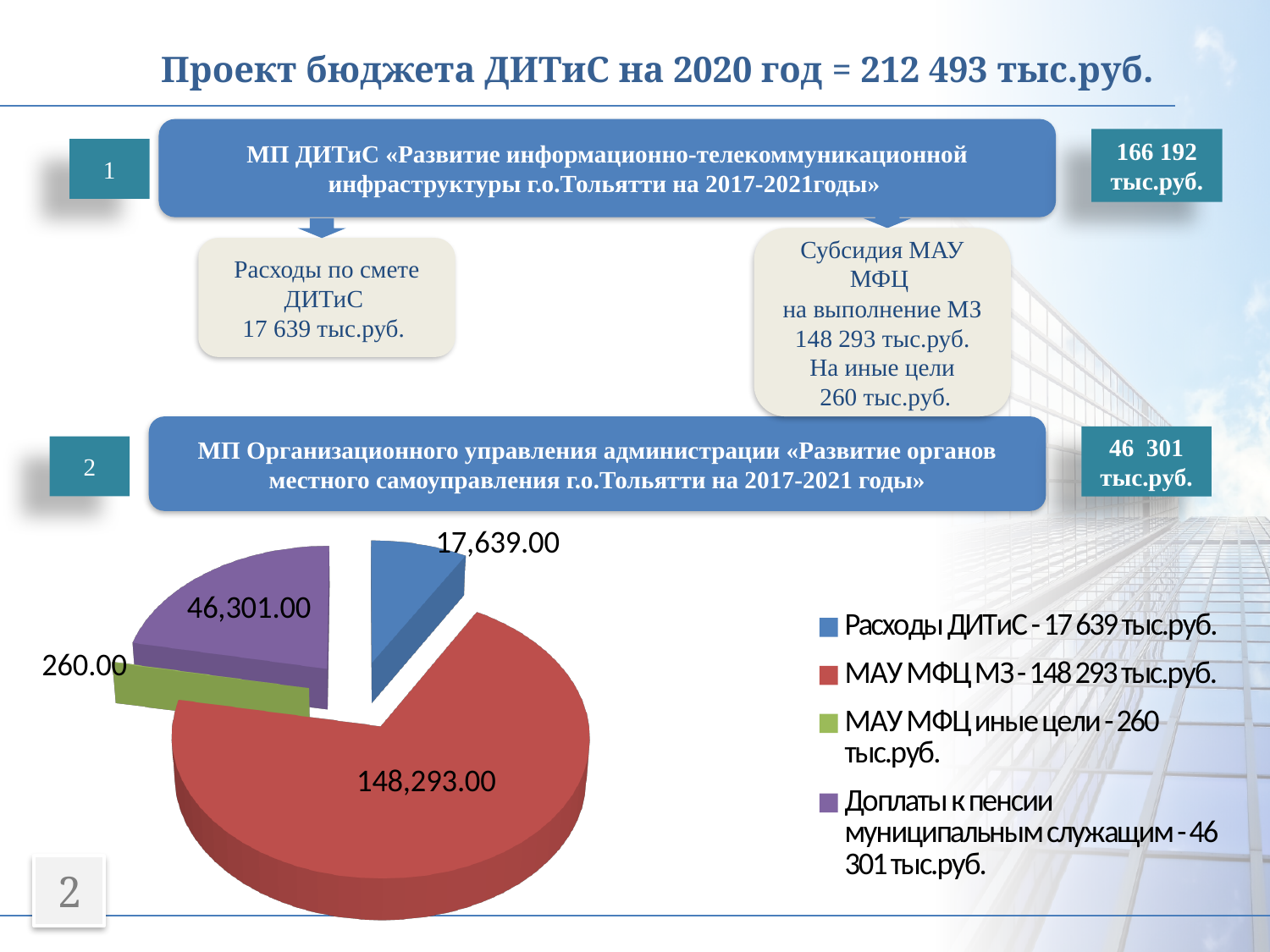
What is the value of the slice for МАУ МФЦ МЗ in the pie chart? 148,293.00 What is the value of the slice for Расходы ДИТиС in the pie chart? 17,639.00 Which is larger in the pie chart: Расходы ДИТиС or Доплаты к пенсии муниципальным служащим? Доплаты к пенсии муниципальным служащим Which category has the smallest slice in the pie chart? МАУ МФЦ иные цели What is the difference between the МАУ МФЦ МЗ slice and the Доплаты к пенсии муниципальным служащим slice? 101,992.00 What is the value of the slice for МАУ МФЦ иные цели in the pie chart? 260.00 What is the value of the slice for Доплаты к пенсии муниципальным служащим in the pie chart? 46,301.00 How many slices does the pie chart have? 4 How many entries does the legend of the pie chart list? 4 Which category has the largest slice in the pie chart? МАУ МФЦ МЗ What type of chart is shown on the slide? pie chart What colour is the slice for МАУ МФЦ МЗ in the pie chart? red